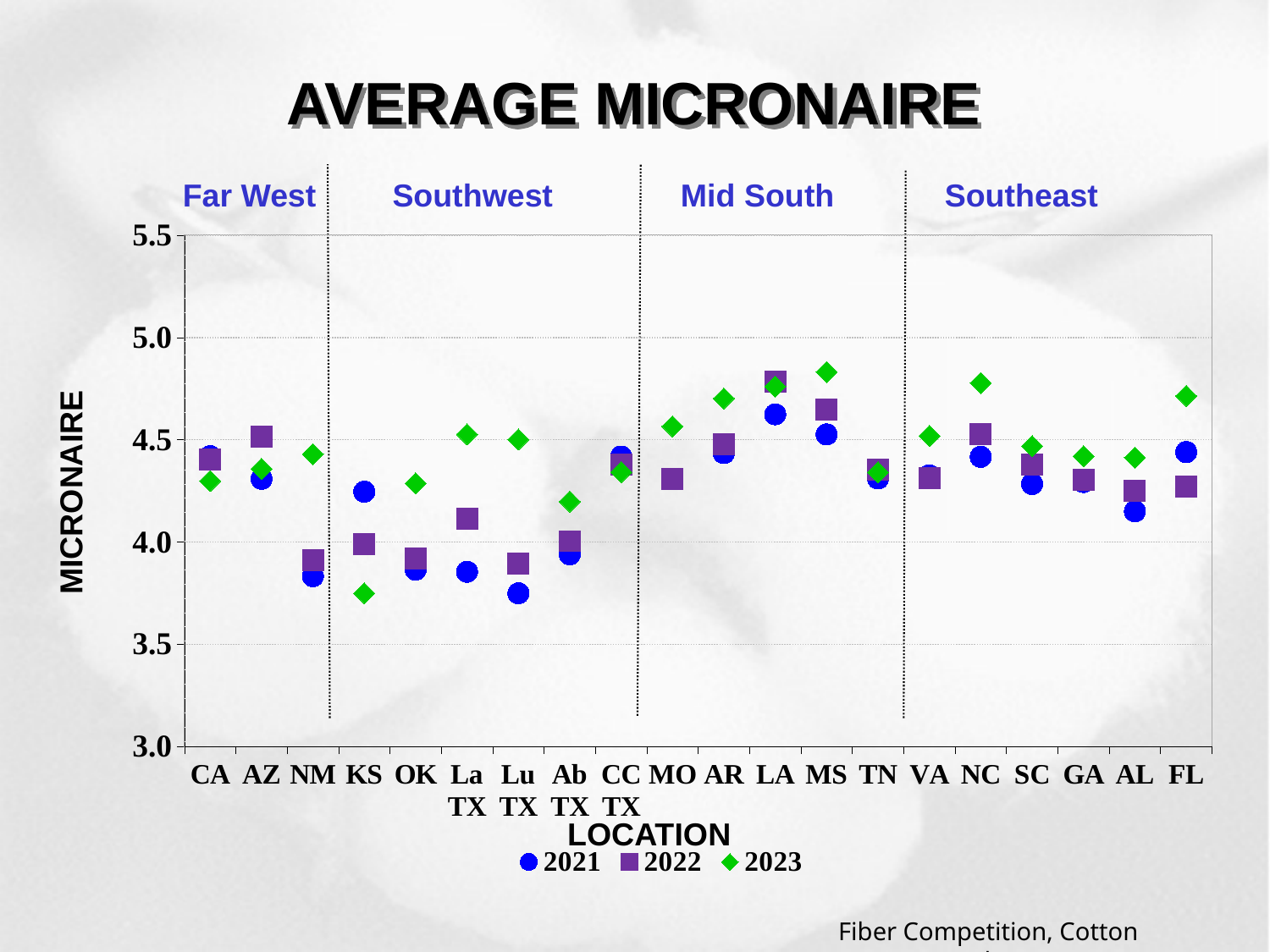
Which location has the lowest 2023 value? KS Which location has the highest 2022 value? LA What kind of chart is shown on the slide? Scatter (dot) chart Is the 2021 value for LA greater or less than 4.5? greater How many locations are plotted along the x axis? 20 Is the 2023 value for MS greater or less than 4.5? greater How many series does the legend list? 3 Is the 2023 value for FL greater or less than 4.5? greater For KS, which year has the larger value, 2021 or 2023? 2021 Which four regions are labelled across the top of the chart? Far West, Southwest, Mid South, Southeast